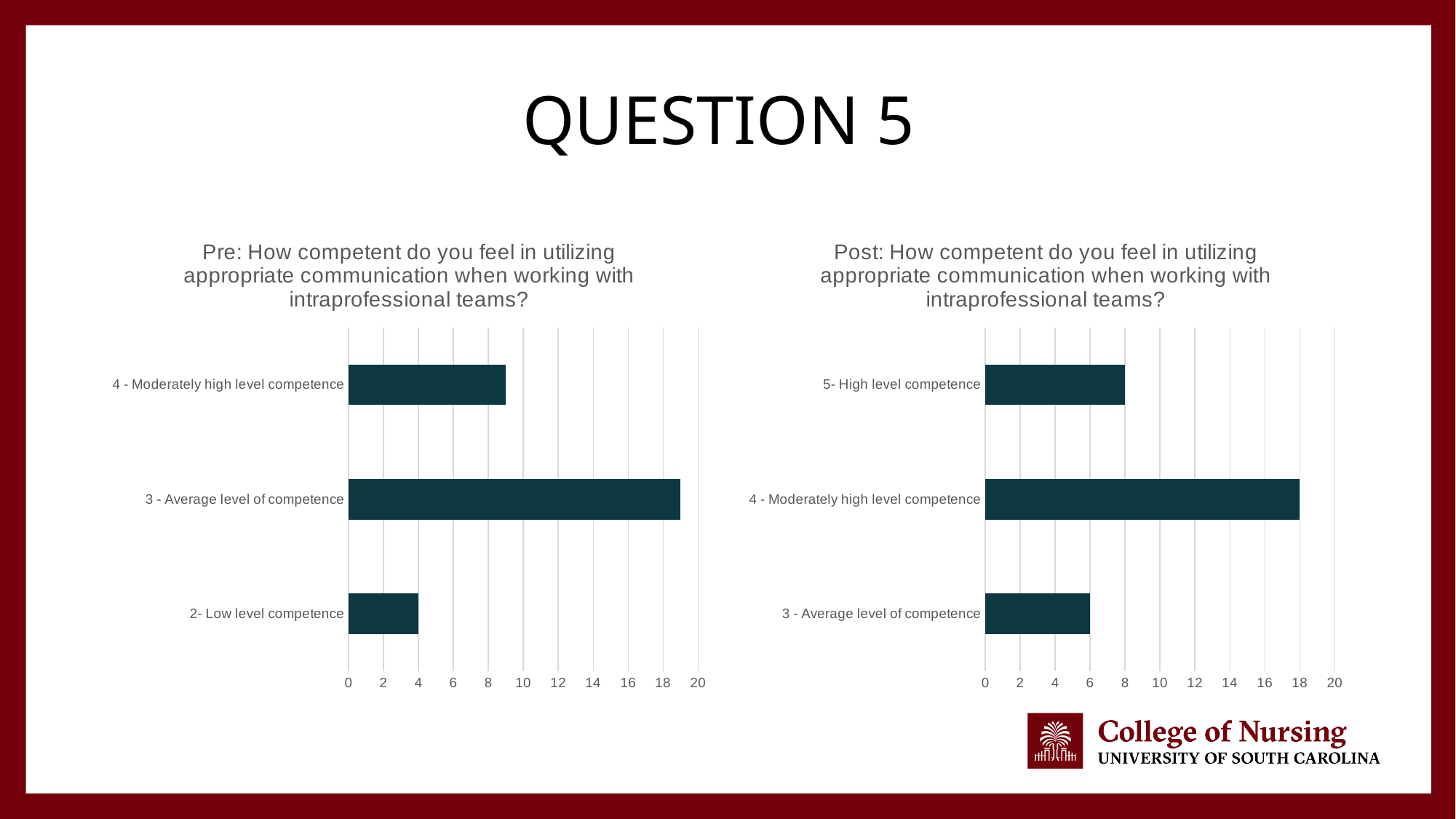
In the Post chart, what is the value for 5- High level competence? 8 In the Pre chart, what is the value for 2- Low level competence? 4 In the Pre chart, which is larger: the value for 4 - Moderately high level competence or 2- Low level competence? 4 - Moderately high level competence In the Post chart, what is the difference between the values for 4 - Moderately high level competence and 5- High level competence? 10 In the Pre chart, is the value for 4 - Moderately high level competence greater or less than 10? less How many categories are shown in the Post chart? 3 In the Post chart, which category has the lowest value? 3 - Average level of competence In the Pre chart, is the value for 3 - Average level of competence greater or less than 16? greater In the Post chart, what is the value for 3 - Average level of competence? 6 What kind of chart is the Pre chart? Bar chart In the Post chart, what is the value for 4 - Moderately high level competence? 18 In the Pre chart, which category has the highest value? 3 - Average level of competence